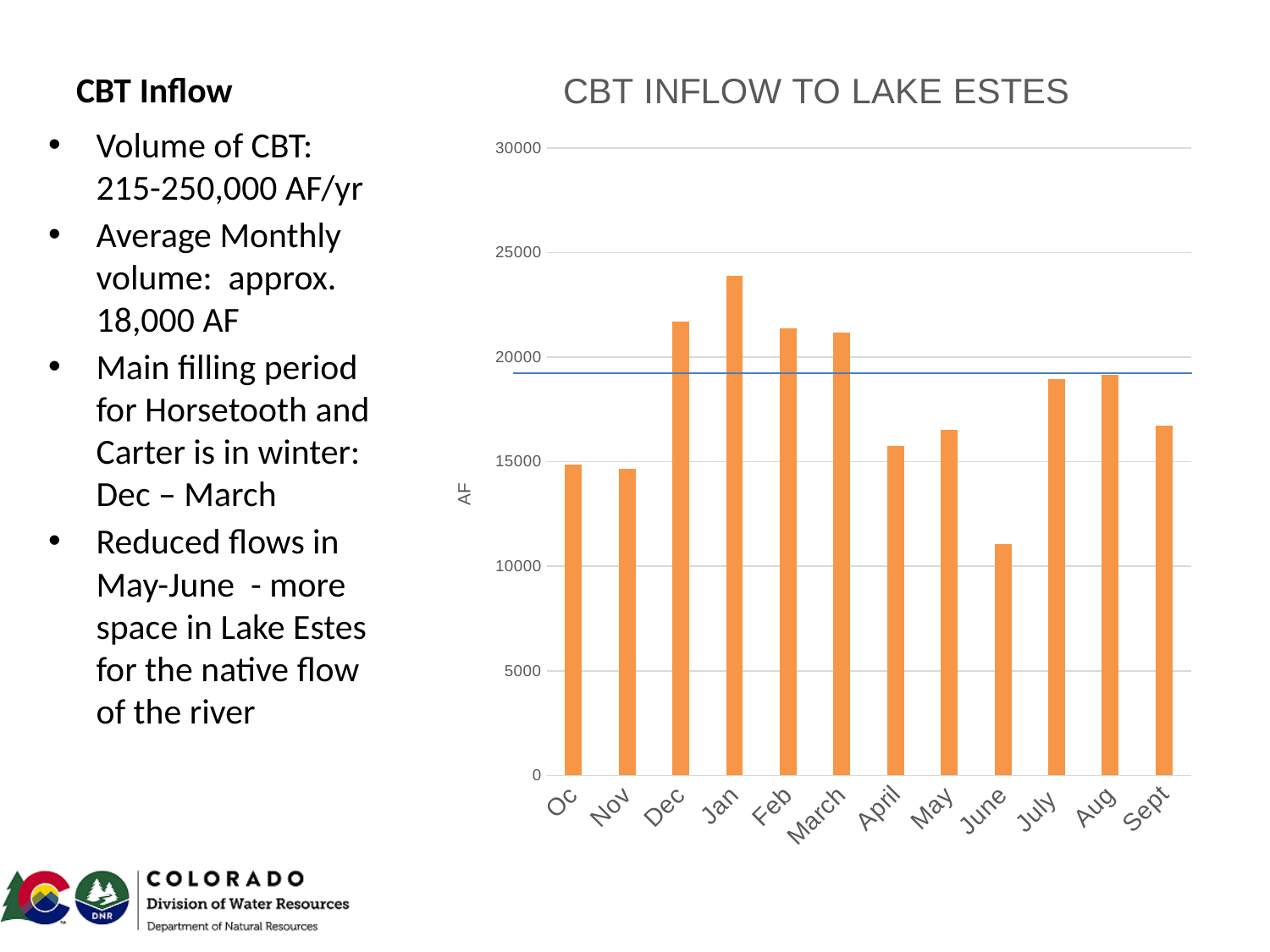
Is the value for June greater or less than 15000? less Which is larger, the value for Dec or the value for April? Dec What is the label on the vertical axis of the chart? AF Which month has the highest CBT inflow to Lake Estes? Jan Do the values rise or fall from Jan to June? fall How many months (categories) are plotted on the x axis? 12 Which month has the lowest CBT inflow to Lake Estes? June Is the value for Jan greater or less than 20000? greater Is the value for Dec greater or less than 20000? greater What kind of chart is shown on the slide? bar chart What is the title of the chart? CBT INFLOW TO LAKE ESTES